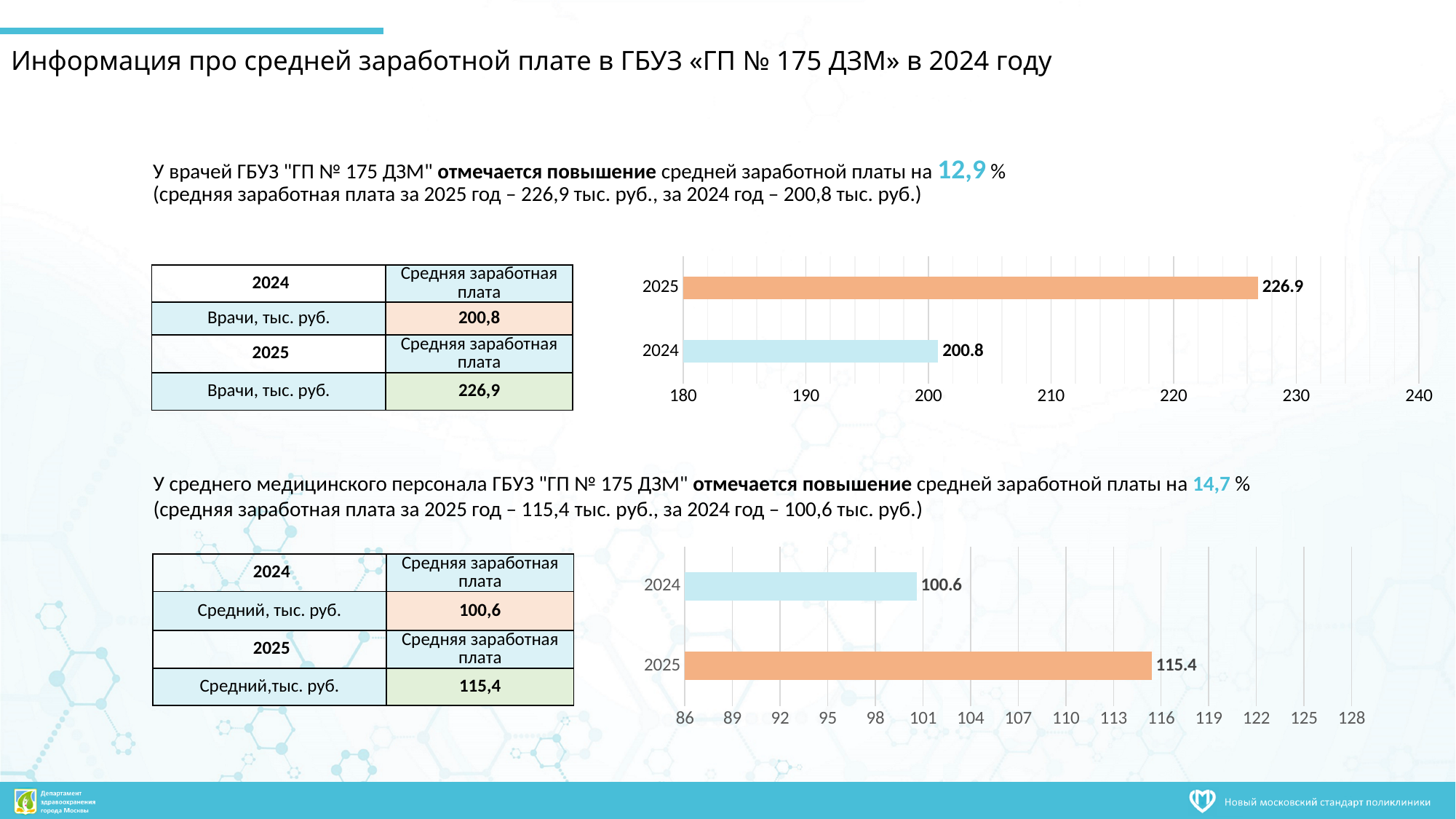
In the bottom chart, what is the value for 2024? 100.6 What type of chart is the bottom chart? bar chart In the top chart, which year has the higher value? 2025 In the bottom chart, what is the value for 2025? 115.4 In the bottom chart, which year has the lower value? 2024 In the top chart, how many bars are plotted? 2 In the bottom chart, what is the difference between the 2025 and 2024 values? 14.8 In the top chart, what is the value for 2025? 226.9 In the bottom chart, is the value for 2025 greater or less than 110? greater In the top chart, what is the difference between the 2025 and 2024 values? 26.1 In the top chart, what is the highest value shown on the horizontal axis? 240 In the top chart, what is the value for 2024? 200.8